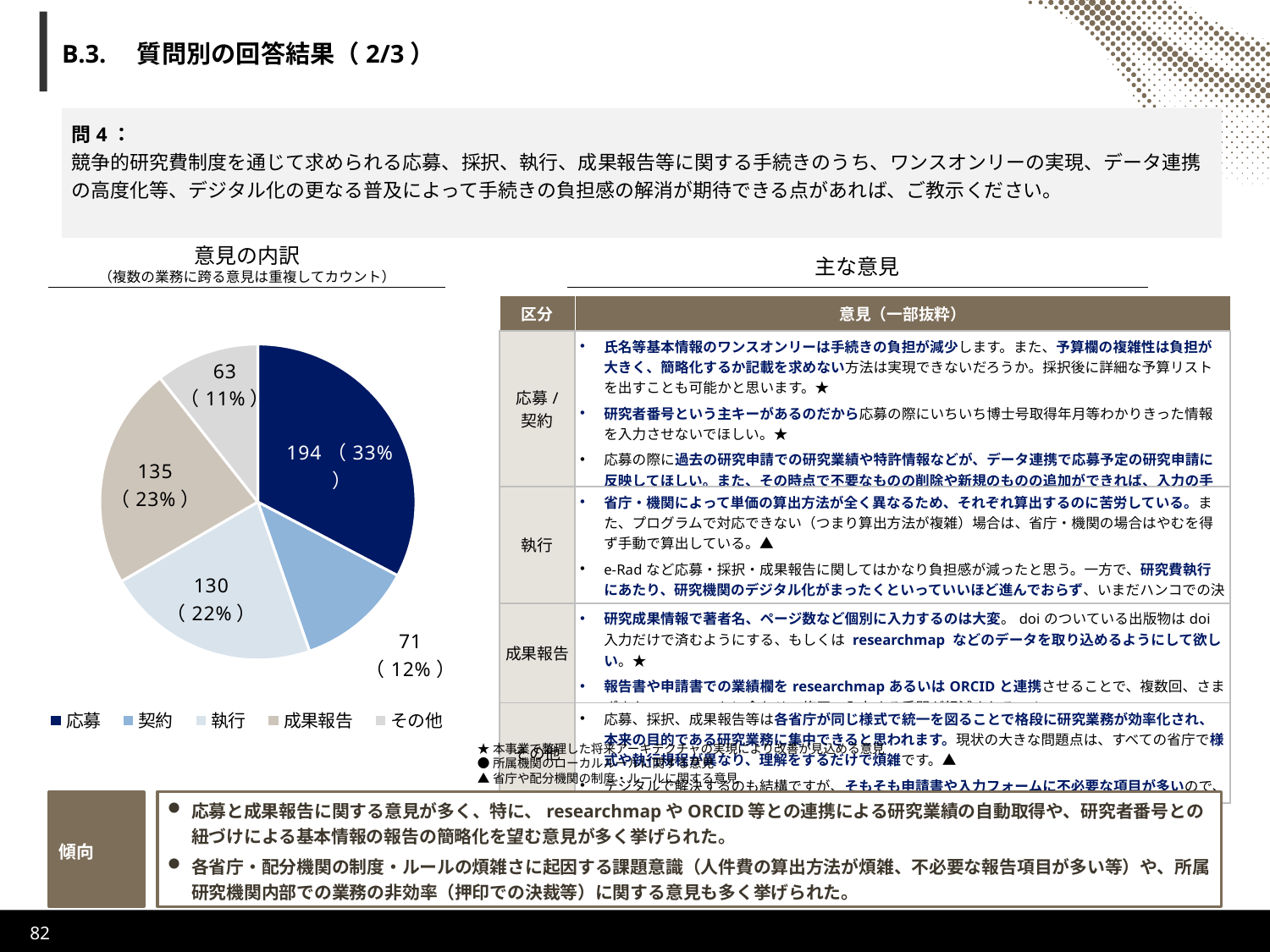
In the pie chart 意見の内訳, how many opinions are counted for 応募? 194 In the pie chart 意見の内訳, which category has the smallest slice? その他 In the pie chart 意見の内訳, what percentage share does 成果報告 have? 23% In the pie chart 意見の内訳, what is the value for 契約? 71 What kind of chart is shown under the title 意見の内訳? pie chart How many categories does the legend of the pie chart 意見の内訳 list? 5 In the pie chart 意見の内訳, what is the value for 執行? 130 In the pie chart 意見の内訳, which category has the largest slice? 応募 In the pie chart 意見の内訳, what percentage share does その他 have? 11% In the pie chart 意見の内訳, what is the difference between the counts for 応募 and 成果報告? 59 In the pie chart 意見の内訳, which is larger, the count for 執行 or the count for 契約? 執行 What is the total of all counts shown in the pie chart 意見の内訳? 593